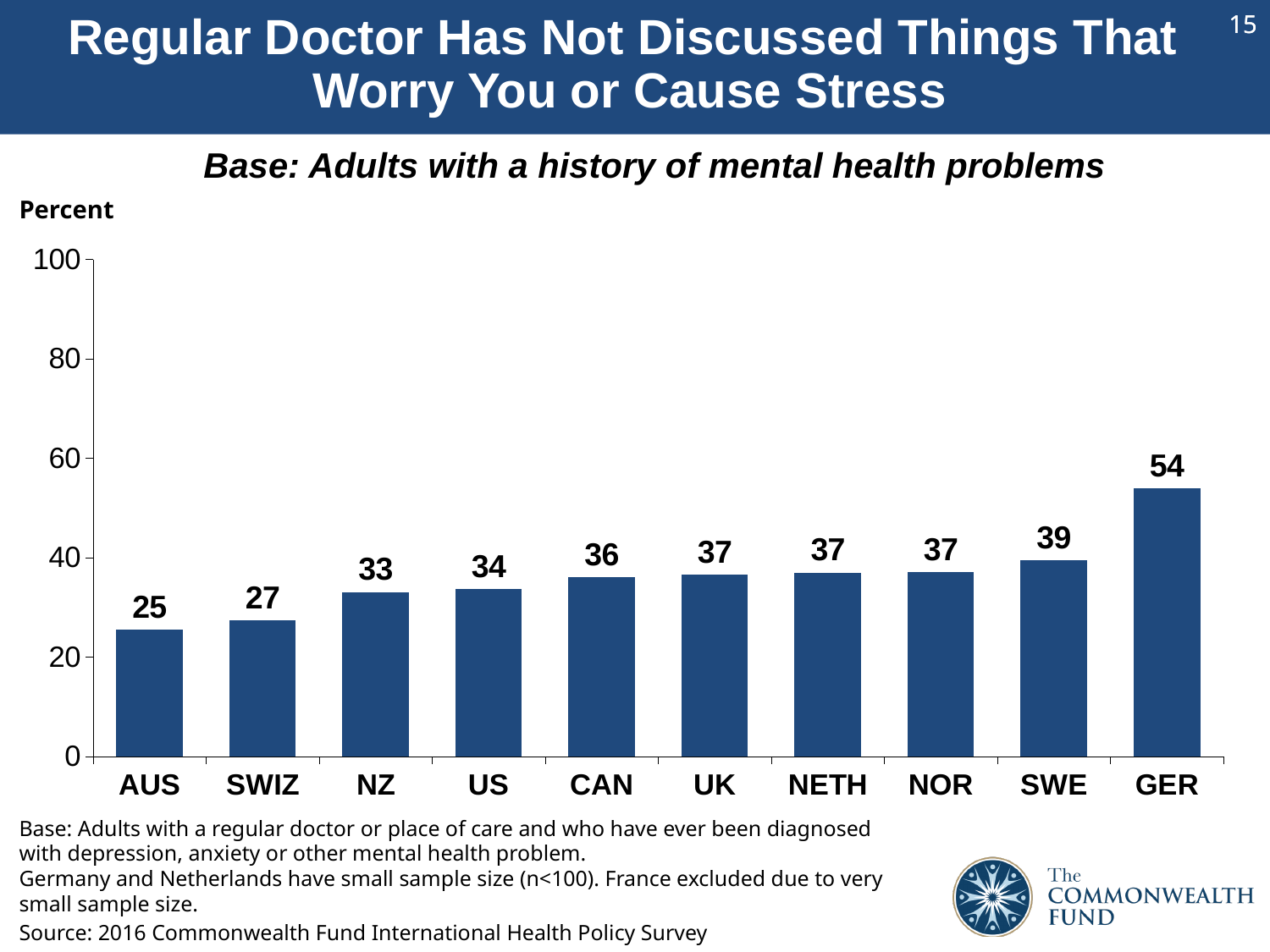
What is the value for CAN? 36 What is the difference between the values for GER and AUS? 29 What kind of chart is shown on the slide? Bar chart What is the difference between the values for SWE and SWIZ? 12 What is the value for GER? 54 Which country has the lowest value? AUS Do the values rise or fall from AUS to GER along the x axis? Rise Is the value for GER greater or less than 40? greater What is the value for AUS? 25 Which is larger, the value for NZ or the value for SWE? SWE How many countries are shown on the x axis? 10 Which country has the highest value? GER